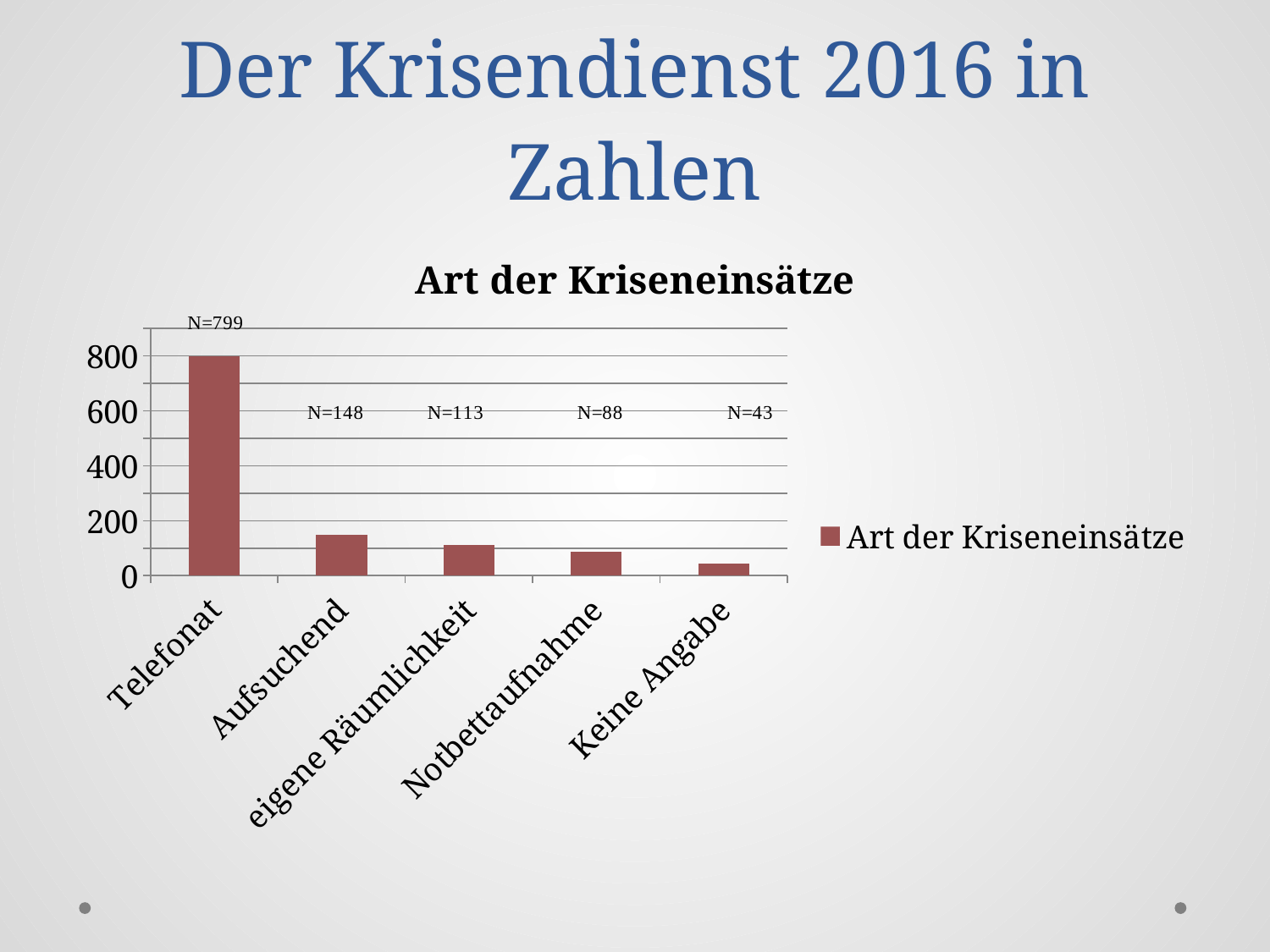
Which category has the lowest value? Keine Angabe What kind of chart is shown on the slide? Bar chart Which category has the highest value? Telefonat What is the value for Keine Angabe? N=43 What is the value for Aufsuchend? N=148 What is the value for eigene Räumlichkeit? N=113 What is the difference between the values for Telefonat and Aufsuchend? 651 What is the value for Notbettaufnahme? N=88 How many categories are shown on the x axis? 5 What is the value for Telefonat? N=799 What is the title of the chart? Art der Kriseneinsätze Which is larger, the value for eigene Räumlichkeit or the value for Notbettaufnahme? eigene Räumlichkeit